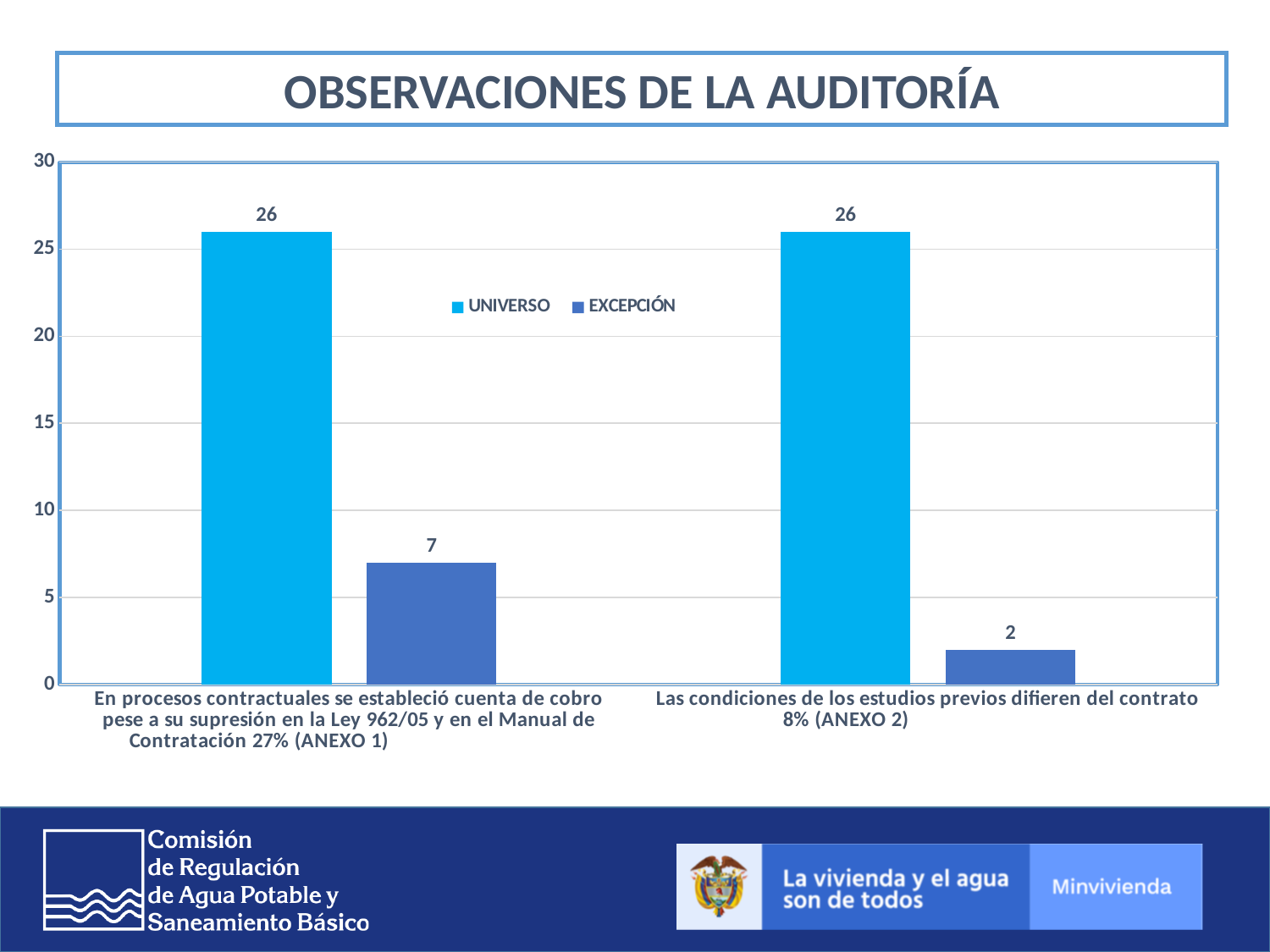
How many series does the legend list? 2 How many categories are shown on the x axis? 2 Is the EXCEPCIÓN value for the ANEXO 1 category greater or less than 10? less Which is larger for the ANEXO 2 category, UNIVERSO or EXCEPCIÓN? UNIVERSO What is the difference between the UNIVERSO and EXCEPCIÓN values for the ANEXO 1 category? 19 Which category has the highest EXCEPCIÓN value? En procesos contractuales se estableció cuenta de cobro pese a su supresión en la Ley 962/05 y en el Manual de Contratación 27% (ANEXO 1) Which category has the lowest EXCEPCIÓN value? Las condiciones de los estudios previos difieren del contrato 8% (ANEXO 2) What is the EXCEPCIÓN value for the category 'En procesos contractuales se estableció cuenta de cobro pese a su supresión en la Ley 962/05 y en el Manual de Contratación 27% (ANEXO 1)'? 7 What kind of chart is shown on the slide? Bar chart What is the difference between the EXCEPCIÓN values of the ANEXO 1 and ANEXO 2 categories? 5 What is the EXCEPCIÓN value for the category 'Las condiciones de los estudios previos difieren del contrato 8% (ANEXO 2)'? 2 What is the UNIVERSO value for the category 'Las condiciones de los estudios previos difieren del contrato 8% (ANEXO 2)'? 26